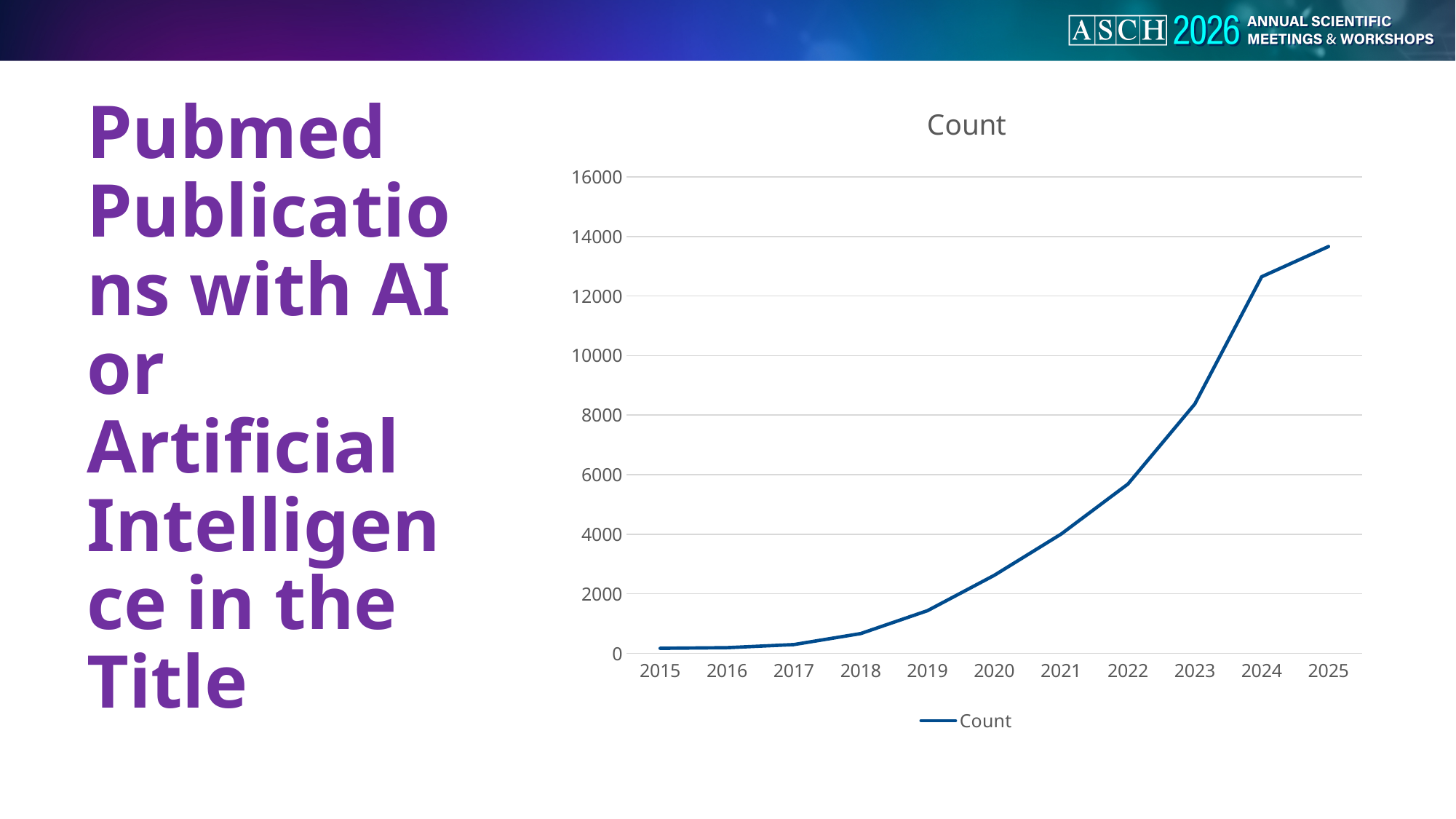
Is the value for 2023 greater or less than 10000? less Is the value for 2024 greater or less than 12000? greater Do the values rise or fall from 2015 to 2025? rise Which year has the highest count? 2025 How many series does the legend list? 1 Which year has the lowest count? 2015 What is the title of the chart? Count Is the value for 2019 greater or less than 2000? less Which is larger, the value for 2022 or the value for 2023? 2023 What kind of chart is shown on the slide? line chart How many years are shown on the x axis? 11